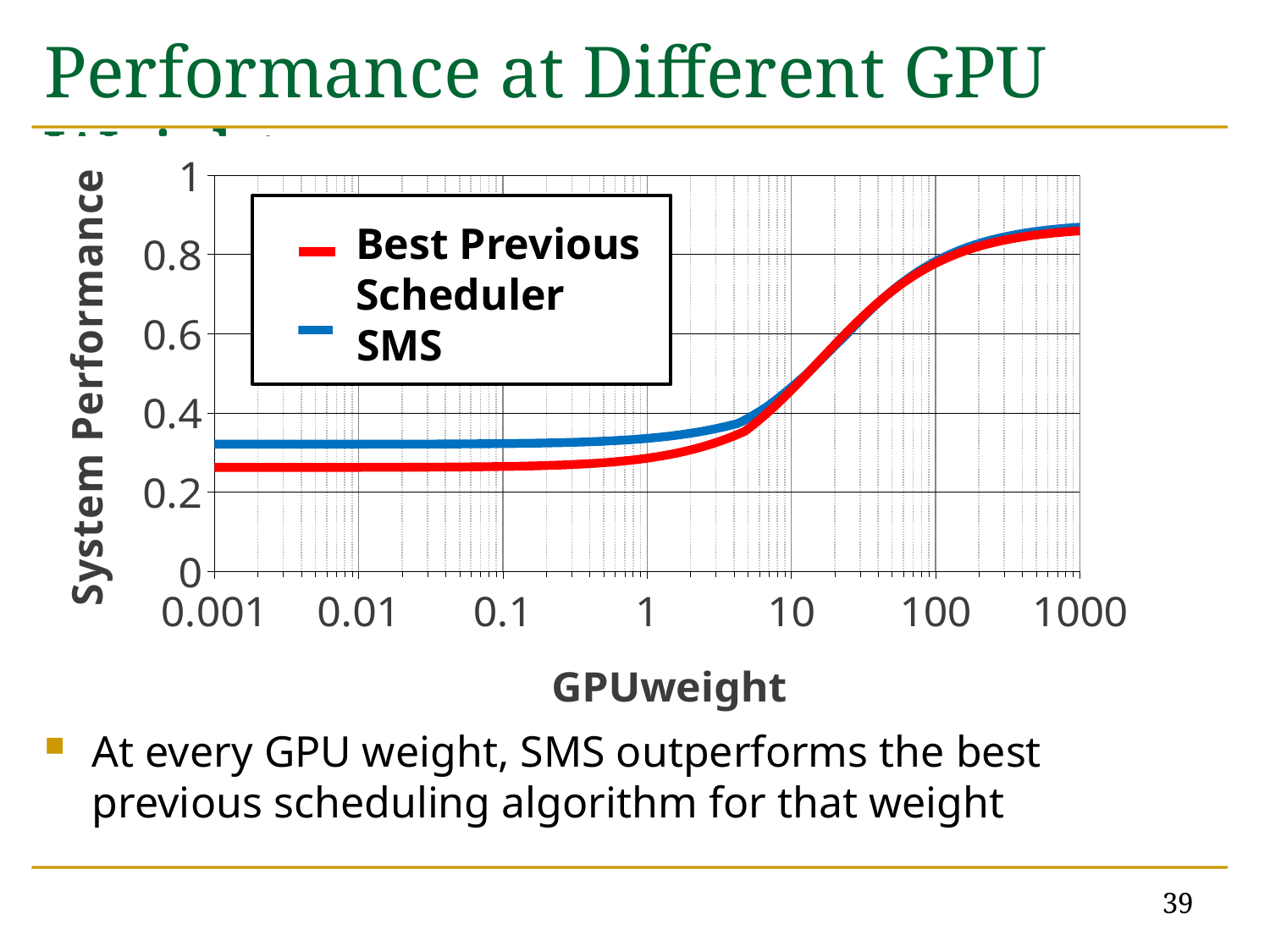
What is the label of the x axis? GPUweight Which series is drawn in red? Best Previous Scheduler How many labeled tick values are shown on the GPUweight axis? 7 Is the System Performance of Best Previous Scheduler at a GPUweight of 0.01 greater or less than 0.4? less Is the System Performance of SMS at a GPUweight of 1000 greater or less than 0.8? greater What kind of chart is shown on the slide? line chart Is the System Performance of SMS at a GPUweight of 0.001 greater or less than 0.4? less At a GPUweight of 0.001, which series has the higher System Performance, SMS or Best Previous Scheduler? SMS How many series does the legend list? 2 Do the System Performance values rise or fall as GPUweight increases along the x axis? rise